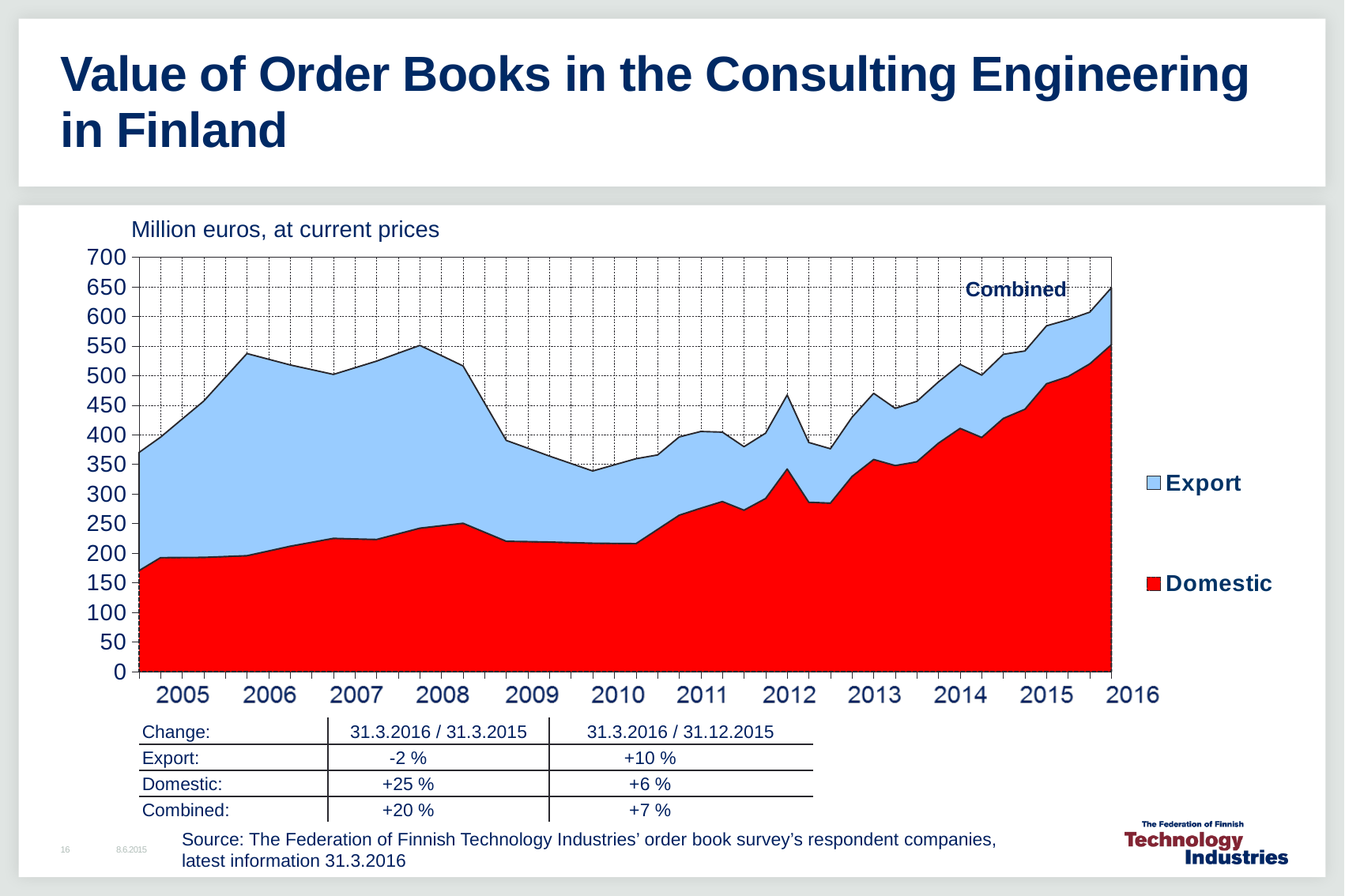
According to the change table below the chart, what is the Domestic change for 31.3.2016 / 31.3.2015? +25 % Is the Combined value at its 2010 low point greater or less than 400? less Is the Combined value at the end of the chart (2016) greater or less than 600? greater How many years are labelled on the x axis of the chart? 12 What unit is stated above the chart for the values? Million euros, at current prices Which two series are listed in the chart's legend? Export and Domestic Is the Domestic value at the start of 2005 greater or less than 250? less Does the Domestic series rise or fall between 2012 and 2016? rise Does the Combined line rise or fall between 2008 and 2010? fall How many series does the chart's legend list? 2 What kind of chart is shown on the slide? Stacked area chart